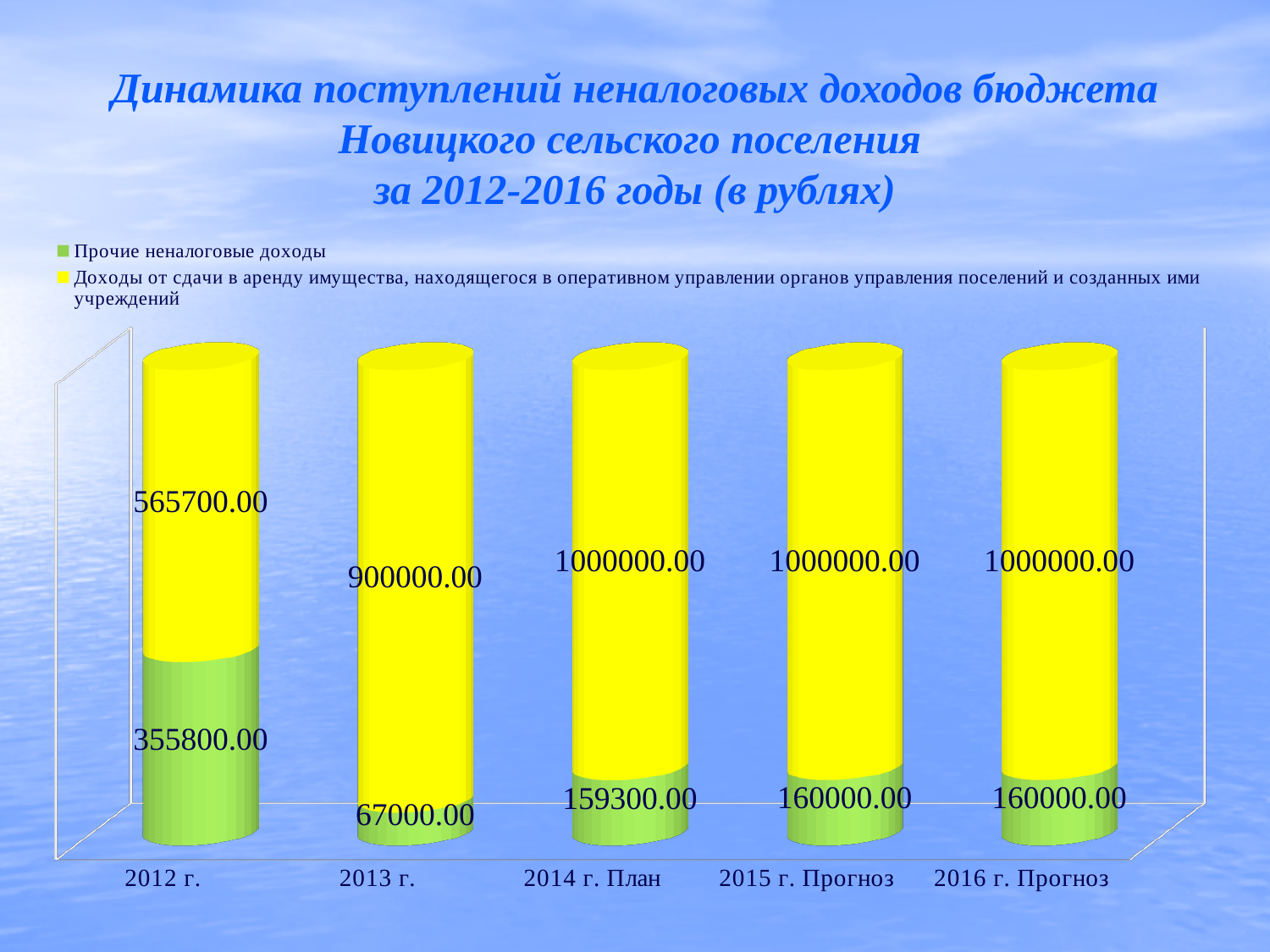
What is the total of the stacked bar for 2014 г. План? 1159300.00 How many categories (years) are shown on the x axis? 5 What is the value of Доходы от сдачи в аренду имущества for 2013 г.? 900000.00 What is the difference between Доходы от сдачи в аренду имущества in 2013 г. and in 2012 г.? 334300.00 In which year is the value of Прочие неналоговые доходы the lowest? 2013 г. What is the value of Прочие неналоговые доходы for 2014 г. План? 159300.00 What is the value of Прочие неналоговые доходы for 2012 г.? 355800.00 What is the value of Доходы от сдачи в аренду имущества for 2016 г. Прогноз? 1000000.00 What is the total of the stacked bar for 2012 г.? 921500.00 In which year is the value of Прочие неналоговые доходы the highest? 2012 г. How many series does the legend list? 2 Which is larger: Прочие неналоговые доходы in 2012 г. or in 2015 г. Прогноз? 2012 г.